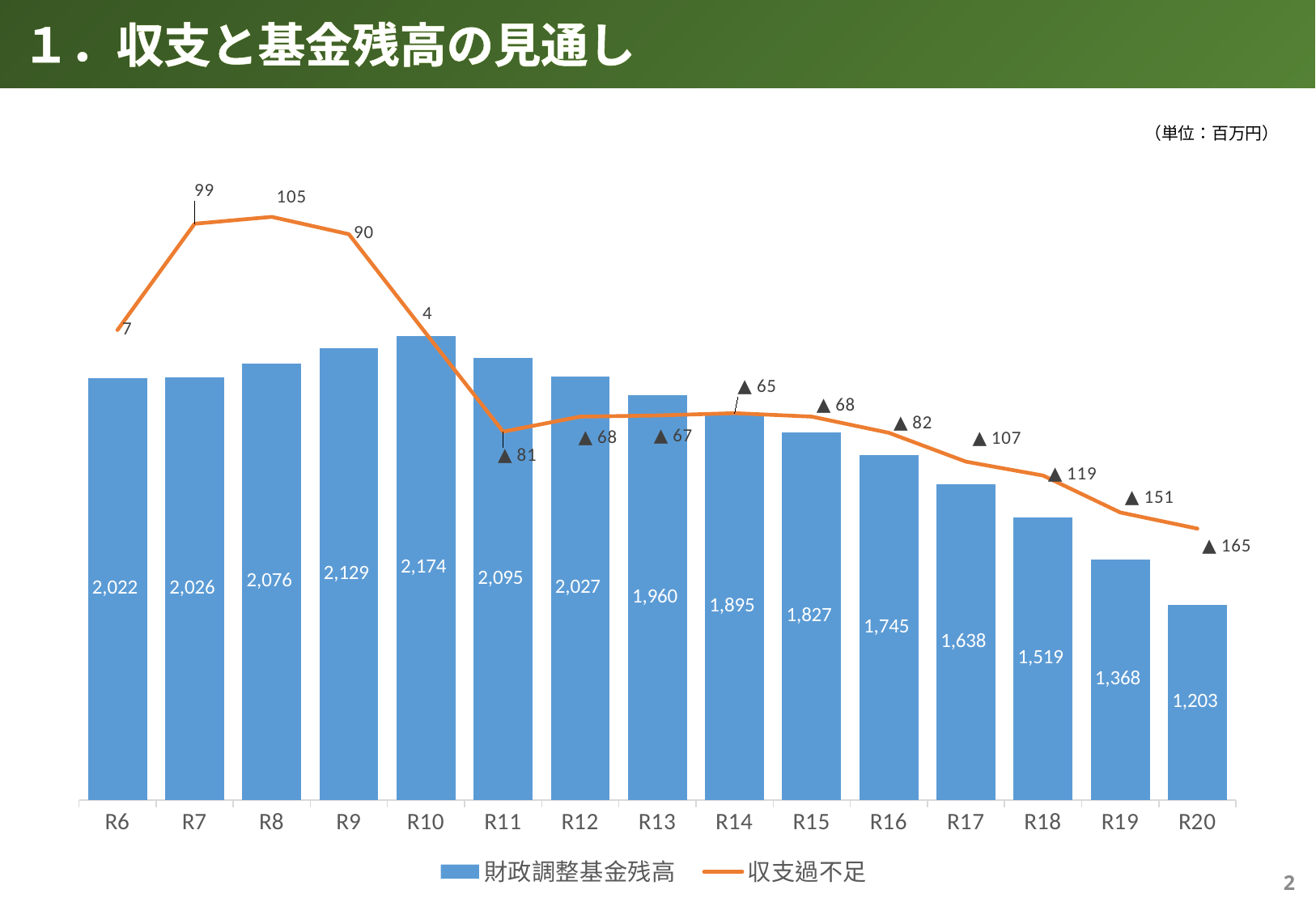
What is the value of 収支過不足 for R20? ▲ 165 How many years are shown on the x axis? 15 Which year has the highest 財政調整基金残高? R10 How many series does the legend list? 2 What kind of chart is shown on the slide? Combined bar and line chart Does the 財政調整基金残高 rise or fall from R10 to R20? Fall What is the value of 収支過不足 for R8? 105 What is the value of 財政調整基金残高 for R10? 2,174 What unit is stated for the values in the chart? 百万円 Which is larger, the 財政調整基金残高 for R9 or for R12? R9 What is the difference in 財政調整基金残高 between R10 and R20? 971 Which year has the lowest 財政調整基金残高? R20